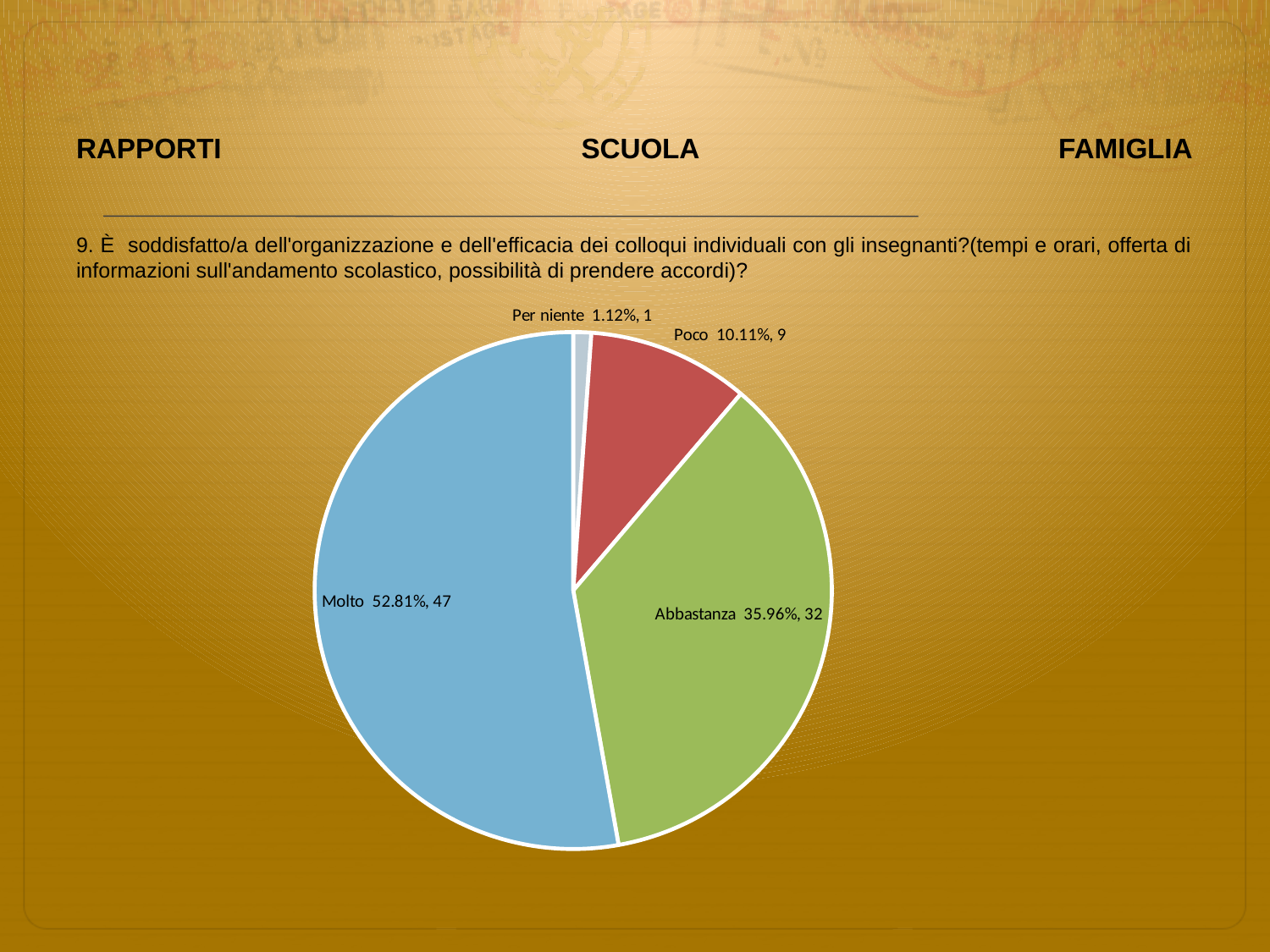
What percentage share does the 'Molto' slice have? 52.81% What percentage share does the 'Abbastanza' slice have? 35.96% Which category has the smallest slice? Per niente What is the count shown for the 'Molto' slice? 47 What is the count shown for the 'Per niente' slice? 1 What is the count shown for the 'Poco' slice? 9 How many slices does the pie chart have? 4 What colour is the 'Poco' slice? red Which is larger, the 'Poco' slice or the 'Abbastanza' slice? Abbastanza Which category has the largest slice? Molto What is the difference in count between 'Molto' and 'Abbastanza'? 15 What kind of chart is shown on the slide? pie chart